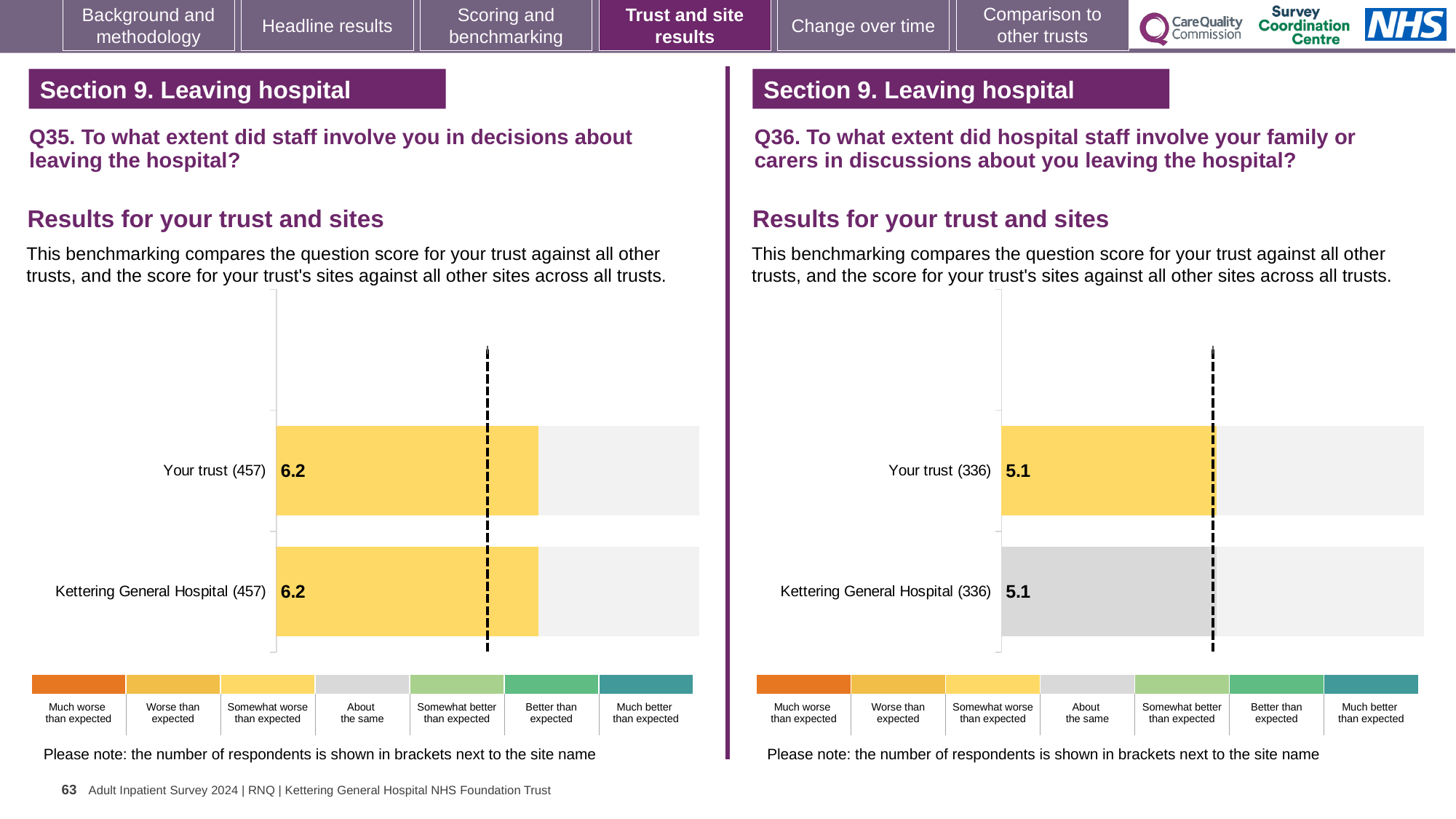
In the Q35 chart on the left, what is the score for Your trust? 6.2 In the Q35 chart on the left, what is the score for Kettering General Hospital? 6.2 In the Q35 chart on the left, what is the difference between the score for Your trust and the score for Kettering General Hospital? 0 In the Q36 chart on the right, what is the score for Kettering General Hospital? 5.1 In the Q36 chart on the right, which benchmark category does the grey colour of the Kettering General Hospital bar represent? About the same How many benchmark categories are listed in the colour key below the Q36 chart on the right? 7 In the Q35 chart on the left, which benchmark category does the yellow colour of the Your trust bar represent? Somewhat worse than expected What kind of chart is used in the Q35 chart on the left? Bar chart In the Q36 chart on the right, what is the score for Your trust? 5.1 In the Q35 chart on the left, how many respondents are shown in brackets next to Kettering General Hospital? 457 How many bars are plotted in the Q36 chart on the right? 2 In the Q36 chart on the right, how many respondents are shown in brackets next to Your trust? 336